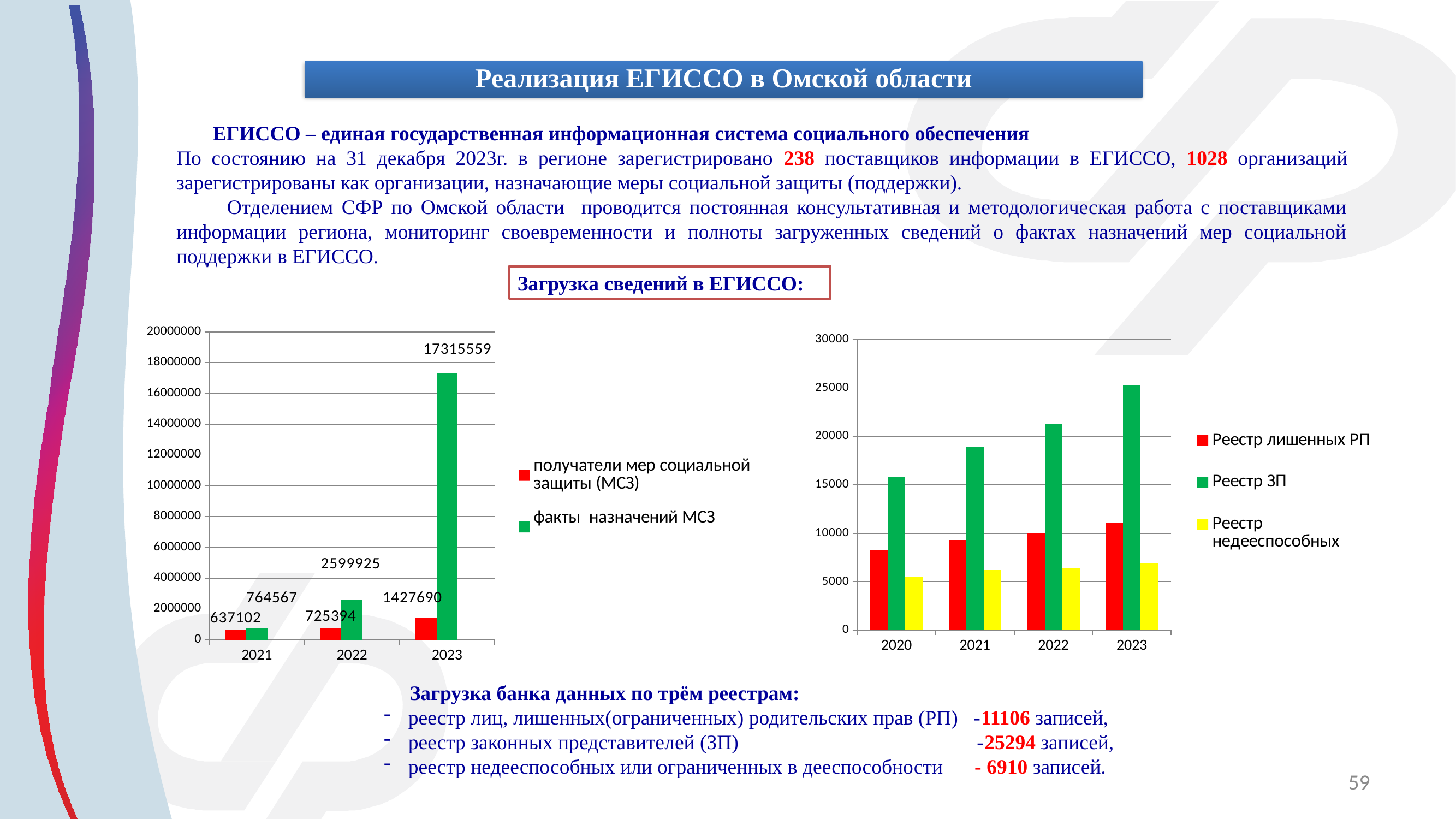
On the left chart, what is the value of факты назначений МСЗ for 2022? 2599925 On the right chart, is the value of Реестр ЗП for 2023 greater or less than 25000? greater On the right chart, is the value of Реестр лишенных РП for 2020 greater or less than 10000? less On the right chart, which series has the lowest value in 2022? Реестр недееспособных On the left chart, what is the value of получатели мер социальной защиты (МСЗ) for 2021? 637102 What type of chart is the right chart? bar chart On the left chart, in which year is получатели мер социальной защиты (МСЗ) highest? 2023 On the left chart, what is the difference between факты назначений МСЗ and получатели мер социальной защиты (МСЗ) in 2023? 15887869 On the left chart, what is the value of факты назначений МСЗ for 2023? 17315559 On the right chart, how many series does the legend list? 3 On the left chart, how many years are shown on the x axis? 3 On the left chart, does факты назначений МСЗ rise or fall from 2021 to 2023? rise